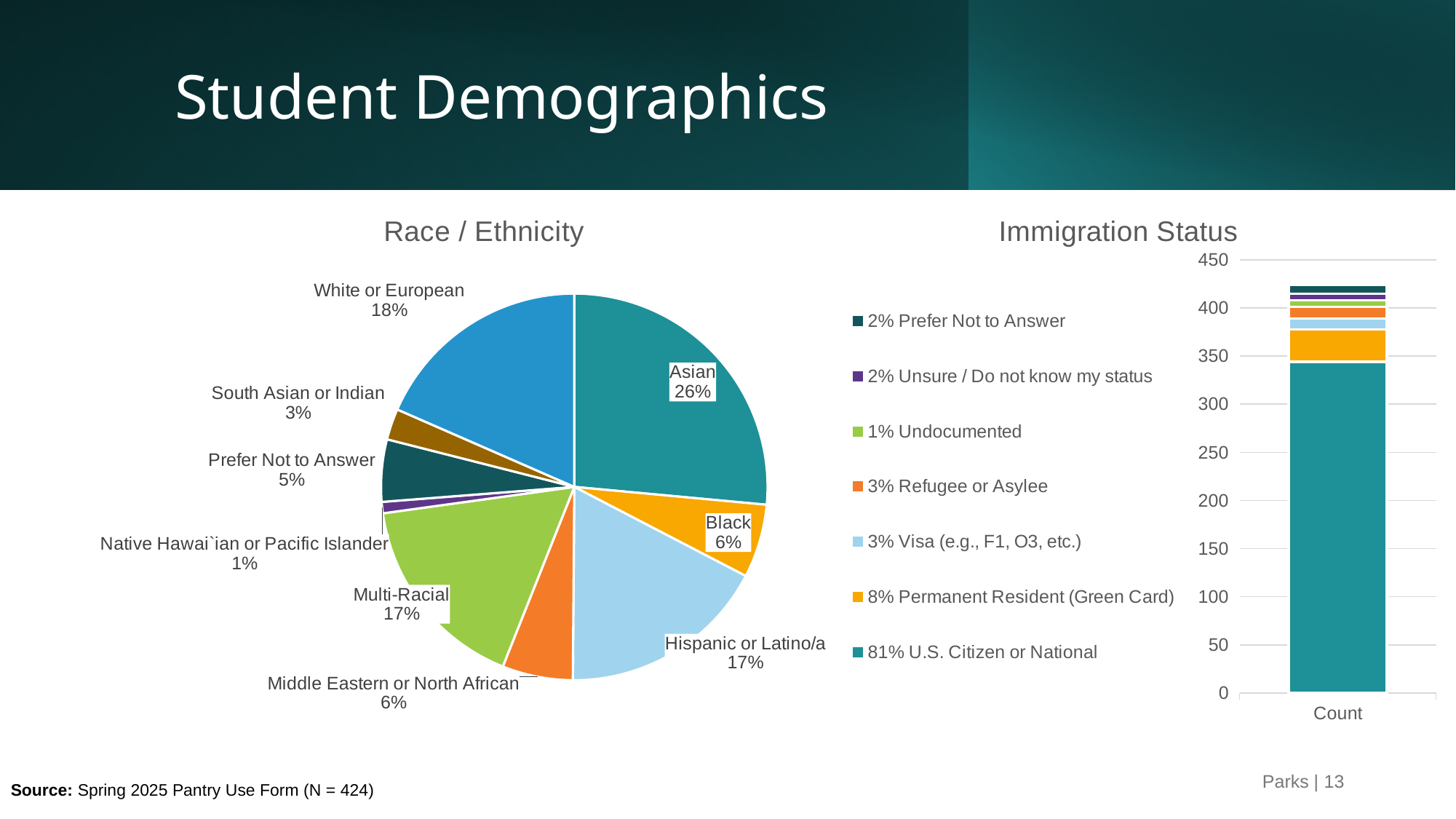
How many series does the legend of the Immigration Status chart list? 7 In the Race / Ethnicity chart, what share is Asian? 26% How many categories are shown in the Race / Ethnicity pie chart? 9 In the Race / Ethnicity chart, which category has the largest share? Asian What kind of chart is the Immigration Status chart? stacked bar chart In the Race / Ethnicity chart, which is larger: Asian or White or European? Asian In the Immigration Status chart, is the count for U.S. Citizen or National greater or less than 300? greater In the Race / Ethnicity chart, which category has the smallest share? Native Hawai`ian or Pacific Islander In the Race / Ethnicity chart, what share is Prefer Not to Answer? 5% What kind of chart is the Race / Ethnicity chart? pie chart In the Race / Ethnicity chart, what is the difference in percentage points between White or European and Black? 12 percentage points In the Immigration Status chart legend, what percentage is shown for Permanent Resident (Green Card)? 8%